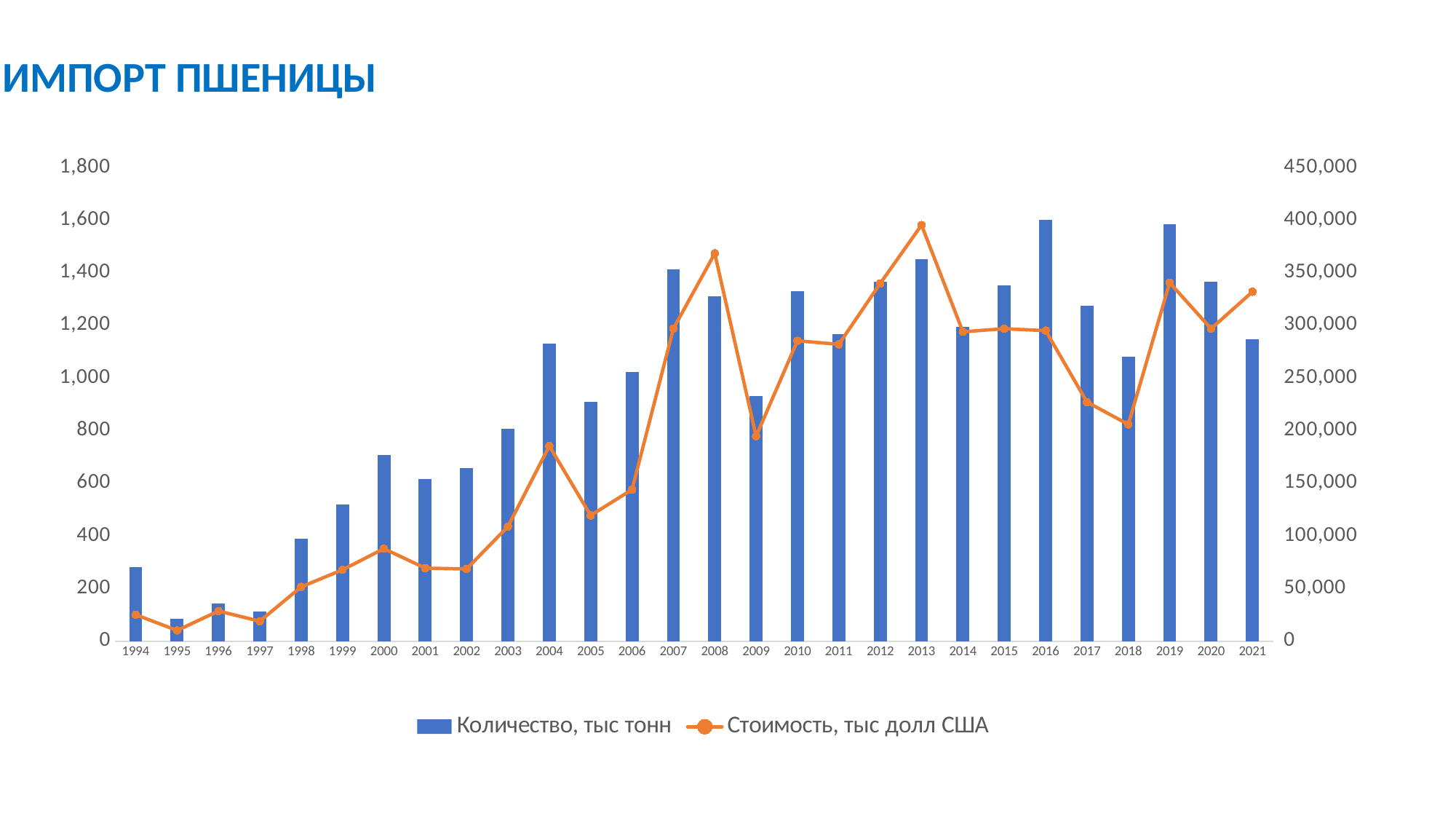
What is the title of the chart? ИМПОРТ ПШЕНИЦЫ How many years are shown on the x axis? 28 Is the Стоимость, тыс долл США value for 2009 greater or less than 200,000? less Is the Количество, тыс тонн bar for 2016 greater or less than 1,400? greater Is the Количество, тыс тонн bar for 2000 greater or less than 800? less How many series does the legend list? 2 Does the Стоимость, тыс долл США line rise or fall overall from 2013 to 2018? fall In which year is the bar for Количество, тыс тонн the lowest? 1995 Which year has the larger Количество, тыс тонн bar, 2007 or 2009? 2007 In which year does the Стоимость, тыс долл США line reach its highest point? 2013 Which series is drawn as a line with markers? Стоимость, тыс долл США What kind of chart is shown on the slide? A combined bar and line chart